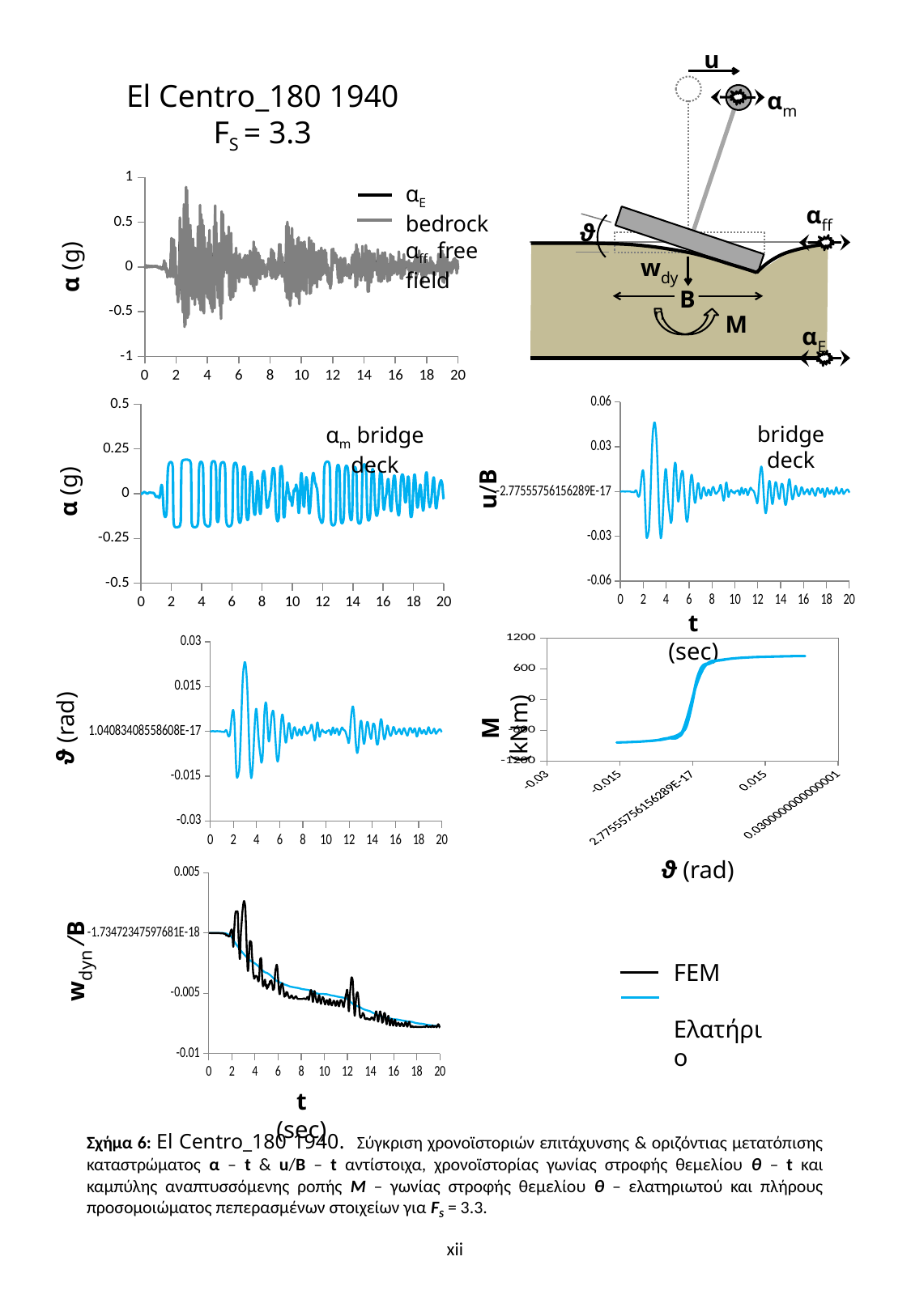
In the w_dyn/B versus t chart, do the values rise or fall as time increases from 0 to 20 sec? fall In the top-left α (g) chart, is the peak bedrock acceleration greater or less than 0.5 g? greater What kind of chart is the w_dyn/B versus t chart at the bottom left of the slide? line chart How many series does the legend of the w_dyn/B versus t chart list? 2 In the α_m bridge deck chart, is the peak acceleration greater or less than 0.25 g? less In the w_dyn/B versus t chart, is the value at t = 20 sec greater or less than -0.005? less What are the two legend entries of the w_dyn/B versus t chart? FEM and Ελατήριο What is the y-axis label of the chart at the middle right of the slide (the M versus ϑ chart)? M (kNm)